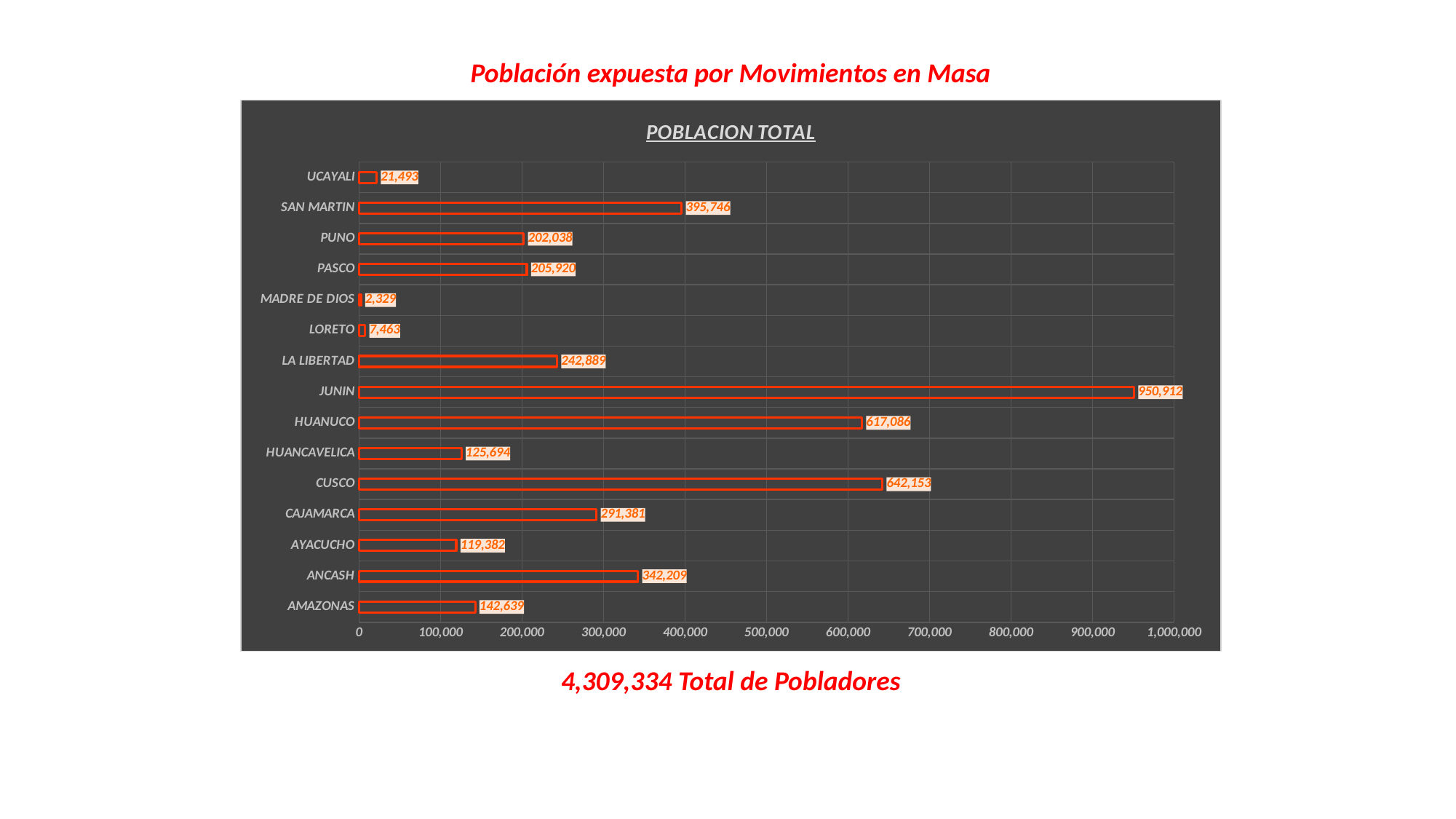
What kind of chart is shown on the slide? bar chart What is the difference between the values for CUSCO and HUANUCO? 25,067 Which category has the lowest value? MADRE DE DIOS Which category has the highest value? JUNIN What is the value for SAN MARTIN? 395,746 What is the value for JUNIN? 950,912 How many categories are shown in the chart? 15 What is the title of the chart? POBLACION TOTAL What is the difference between the values for PASCO and PUNO? 3,882 Is the value for JUNIN greater or less than 900,000? greater Which is larger, the value for ANCASH or the value for CAJAMARCA? ANCASH What is the value for HUANCAVELICA? 125,694